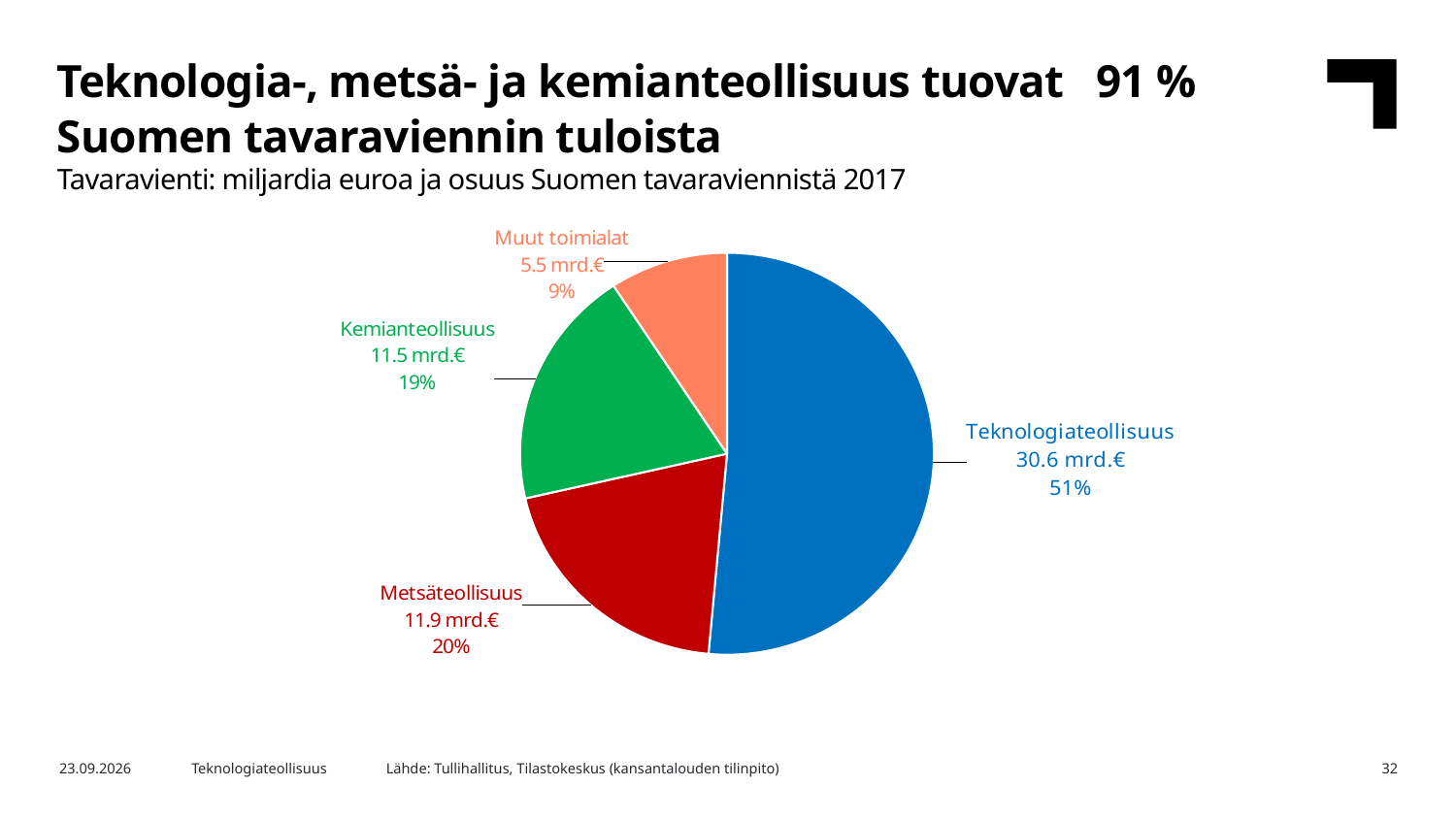
Which category has the smallest slice? Muut toimialat Which category has the largest slice? Teknologiateollisuus What is the value for Metsäteollisuus? 11.9 mrd.€ What is the difference in value between Teknologiateollisuus and Metsäteollisuus? 18.7 mrd.€ What is the value for Muut toimialat? 5.5 mrd.€ What is the value for Teknologiateollisuus? 30.6 mrd.€ How many slices does the pie chart have? 4 What type of chart is shown on the slide? pie chart What is the value for Kemianteollisuus? 11.5 mrd.€ What share of the pie does Teknologiateollisuus represent? 51% What share of the pie does Muut toimialat represent? 9% Which colour is used for the Kemianteollisuus slice? green